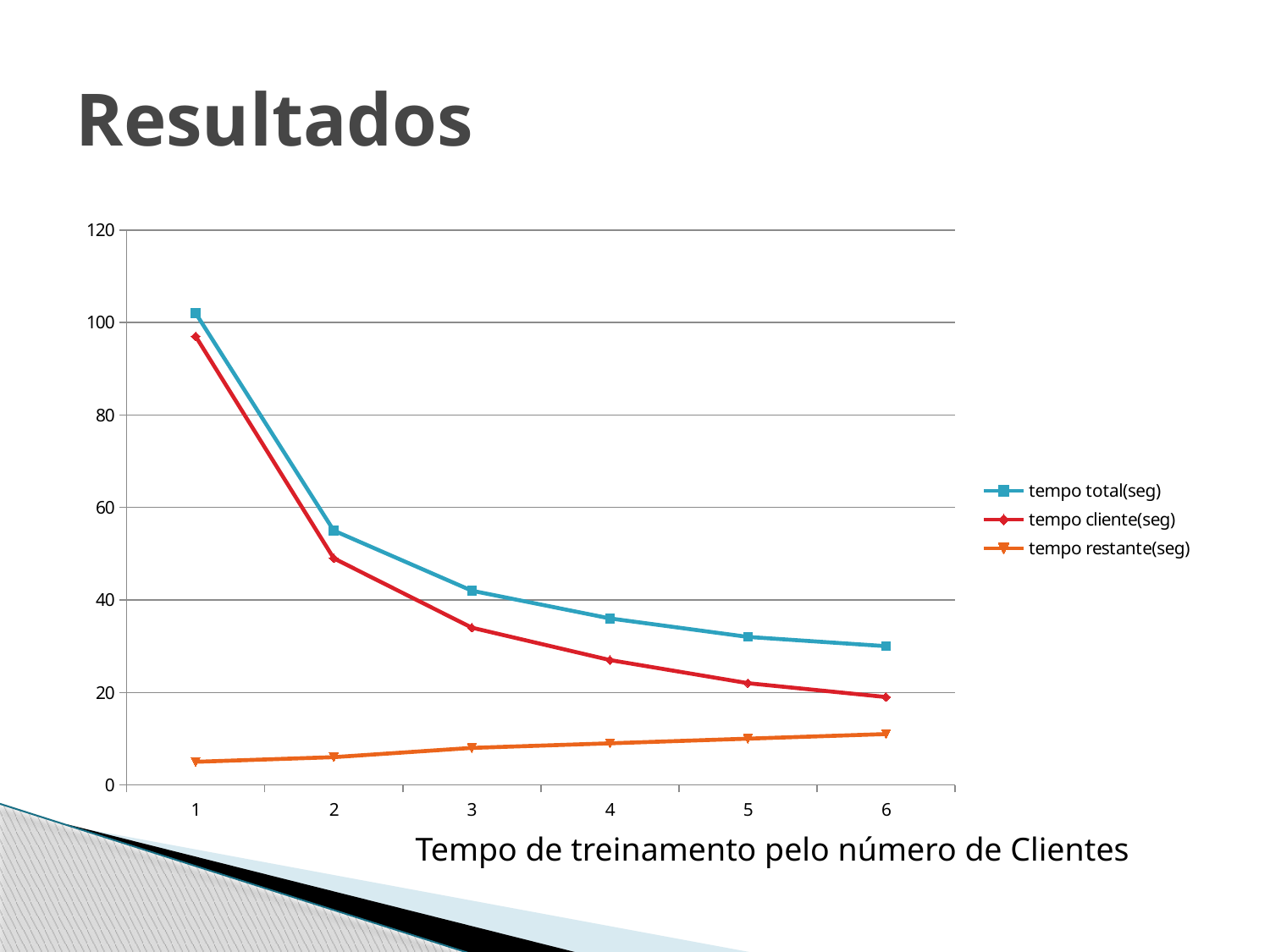
How many series does the legend list? 3 Does the tempo restante(seg) series rise or fall as the number of clients increases from 1 to 6? rise Does the tempo total(seg) series rise or fall as the number of clients increases from 1 to 6? fall How many points are plotted along the x axis for each series? 6 What kind of chart is shown on the slide? line chart Is the value of tempo cliente(seg) at 1 greater or less than 80? greater Is the value of tempo restante(seg) at 6 greater or less than 20? less At which x-axis value is tempo cliente(seg) lowest? 6 What is the title shown below the x axis of the chart? Tempo de treinamento pelo número de Clientes Is the value of tempo total(seg) at 2 greater or less than 40? greater At which x-axis value is tempo total(seg) highest? 1 At x = 4, which is larger: tempo total(seg) or tempo cliente(seg)? tempo total(seg)